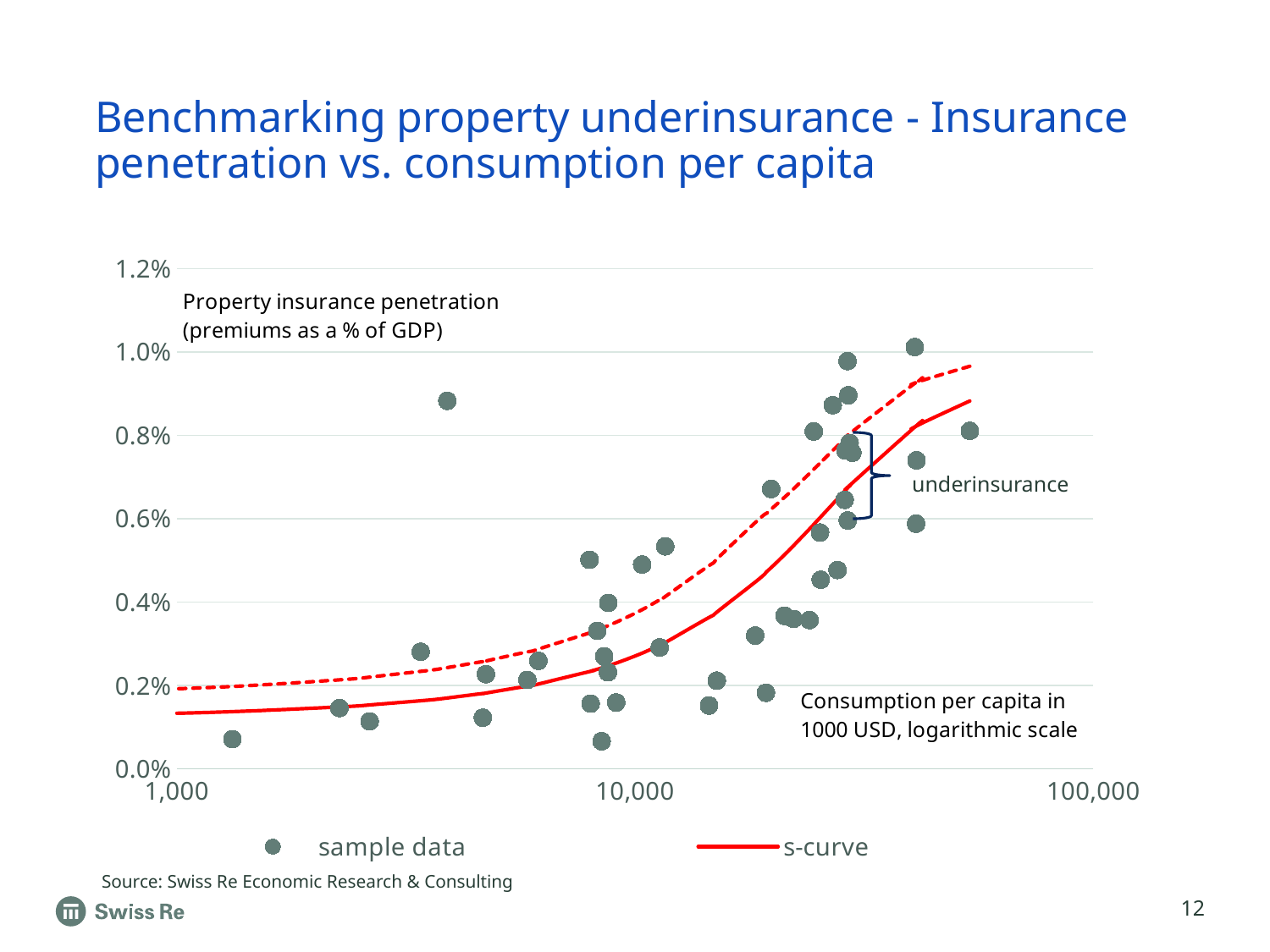
What kind of chart is shown on the slide? scatter chart Is the lowest sample data point greater or less than 0.2%? less What are the two series named in the legend? sample data and s-curve Is the highest sample data point greater or less than 0.8%? greater Is the value of the s-curve at a consumption per capita of 1,000 greater or less than 0.2%? less Does the s-curve rise or fall as consumption per capita increases along the x axis? rise What does the annotation next to the bracket between the dashed and solid curves say? underinsurance How many series does the legend list? 2